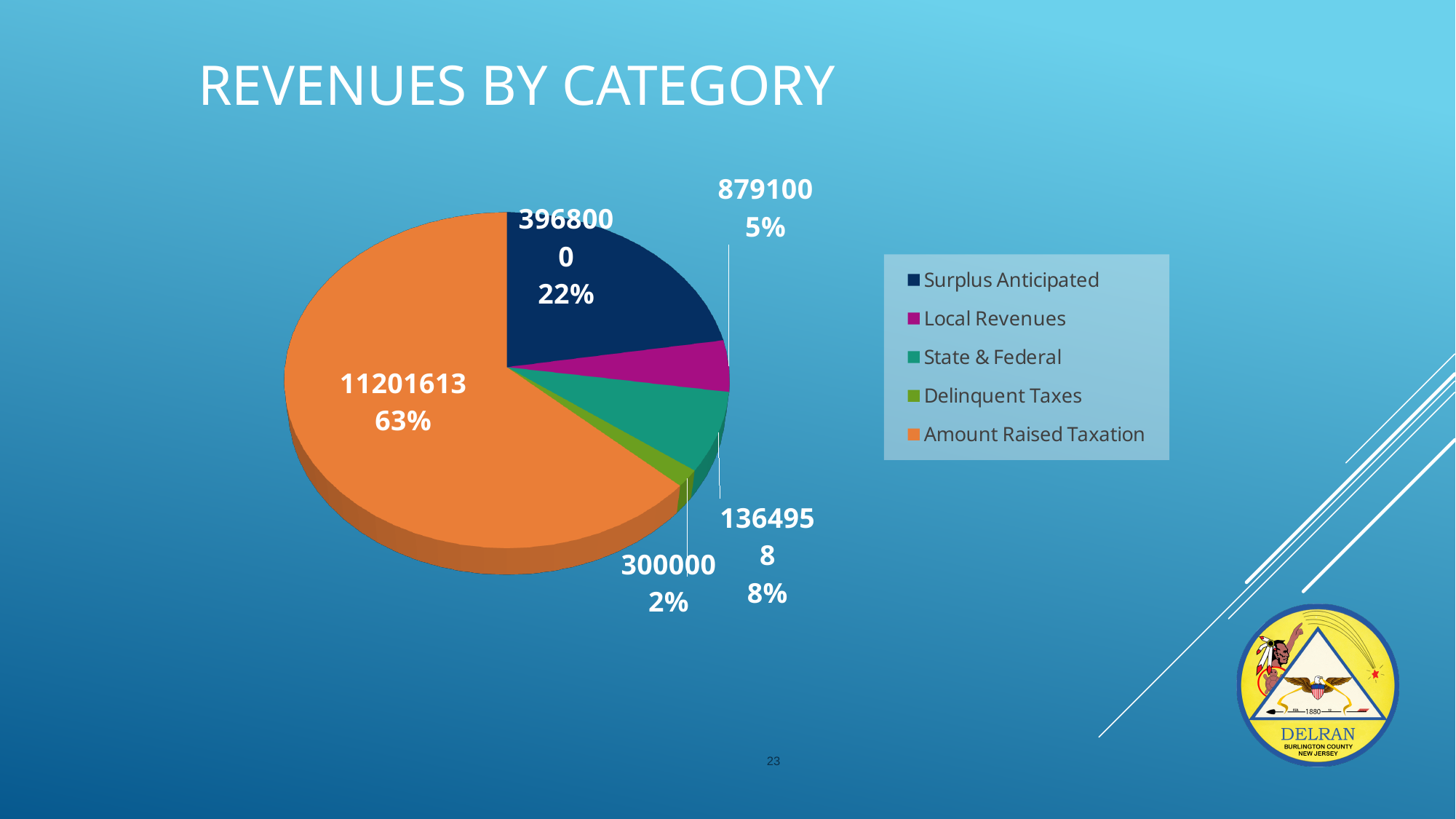
What is the value for Surplus Anticipated? 3968000 What is the title of the chart? REVENUES BY CATEGORY How many categories does the legend list? 5 What is the value for Delinquent Taxes? 300000 What kind of chart is shown on the slide? Pie chart What share of the pie does Amount Raised Taxation represent? 63% Which category has the largest slice? Amount Raised Taxation Which category has the smallest slice? Delinquent Taxes Which is larger, Surplus Anticipated or Local Revenues? Surplus Anticipated What is the value for Amount Raised Taxation? 11201613 What is the value for Local Revenues? 879100 What share of the pie does State & Federal represent? 8%